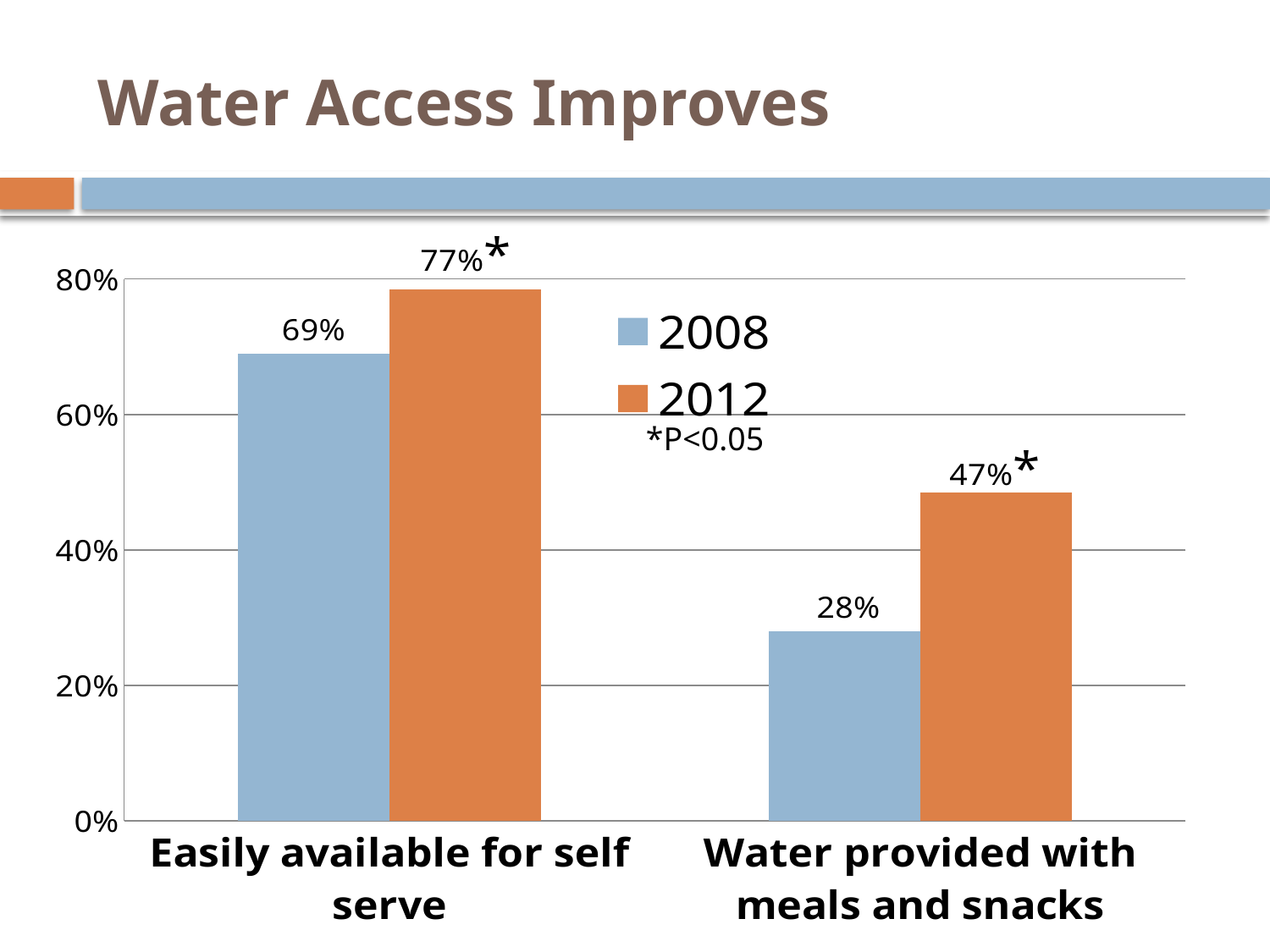
Which is larger: the 2008 value for "Easily available for self serve" or the 2012 value for "Water provided with meals and snacks"? 2008 value for Easily available for self serve Which category has the lowest 2008 value? Water provided with meals and snacks What is the 2008 value for "Water provided with meals and snacks"? 28% What is the difference between the 2012 and 2008 values for "Easily available for self serve"? 8% What is the 2008 value for "Easily available for self serve"? 69% Which category has the highest 2012 value? Easily available for self serve What is the 2012 value for "Water provided with meals and snacks"? 47% What kind of chart is shown on the slide? Bar chart How many categories are shown on the x axis? 2 What is the 2012 value for "Easily available for self serve"? 77% How many series does the legend list? 2 What is the difference between the 2012 and 2008 values for "Water provided with meals and snacks"? 19%